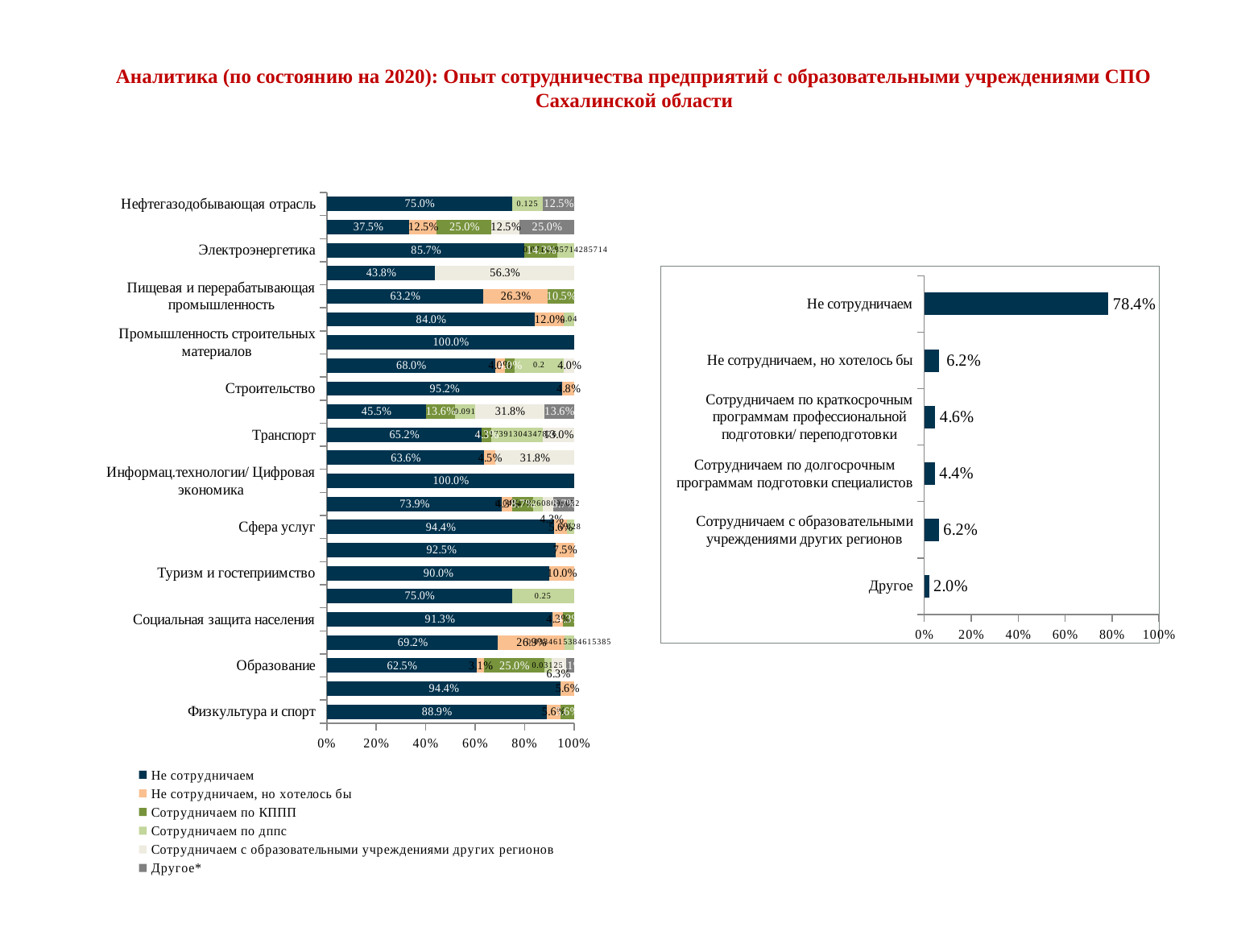
In the right chart, what is the value for "Другое"? 2.0% In the left chart, what is the "Не сотрудничаем" value for "Строительство"? 95.2% In the left chart, how many series does the legend list? 6 In the right chart, is the value for "Не сотрудничаем" greater or less than 60%? greater In the right chart, what is the difference between "Не сотрудничаем" and "Не сотрудничаем, но хотелось бы"? 72.2% In the right chart, what is the value for "Сотрудничаем по долгосрочным программам подготовки специалистов"? 4.4% In the right chart, which is larger: "Сотрудничаем по краткосрочным программам профессиональной подготовки/ переподготовки" or "Сотрудничаем по долгосрочным программам подготовки специалистов"? Сотрудничаем по краткосрочным программам профессиональной подготовки/ переподготовки In the right chart, how many categories are shown? 6 What kind of chart is the left chart? Stacked bar chart In the right chart, which category has the lowest value? Другое In the right chart, which category has the highest value? Не сотрудничаем In the right chart, what is the value for "Не сотрудничаем"? 78.4%